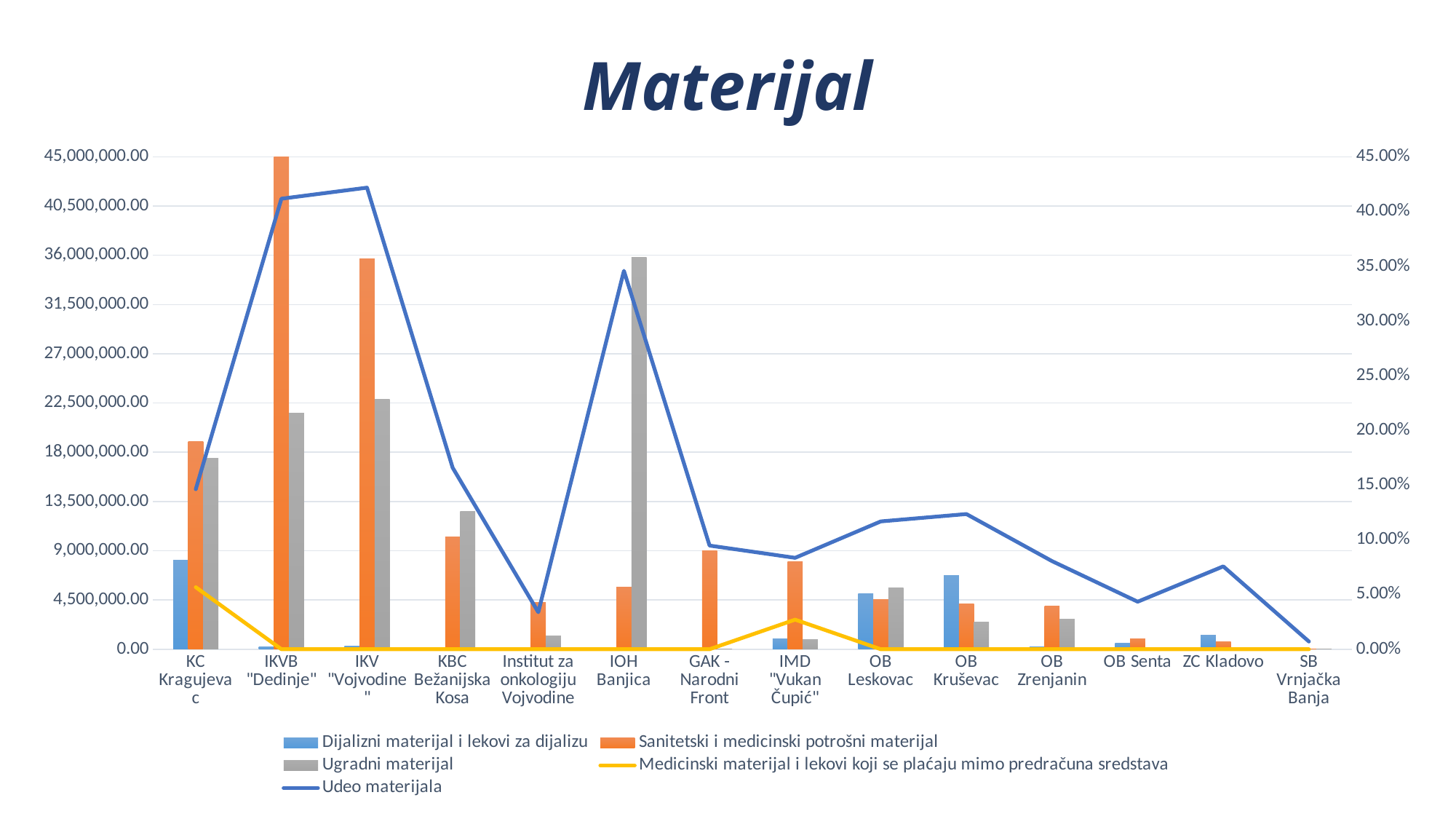
What kind of chart is this? Combination bar and line chart Is the value of Udeo materijala for Institut za onkologiju Vojvodine greater or less than 5.00%? less Is the value of Udeo materijala for IOH Banjica greater or less than 30.00%? greater Is the value of Sanitetski i medicinski potrošni materijal for IKVB "Dedinje" greater or less than 40,500,000.00? greater How many categories (institutions) are shown on the x axis? 14 How many series does the legend list? 5 Which category has the highest value for Ugradni materijal? IOH Banjica Which category has the lowest value for Udeo materijala? SB Vrnjačka Banja Which category has the highest value for Sanitetski i medicinski potrošni materijal? IKVB "Dedinje" Which category has the highest value for Dijalizni materijal i lekovi za dijalizu? KC Kragujevac What is the title of the chart? Materijal Which is larger: Ugradni materijal for IOH Banjica or for IKV "Vojvodine"? IOH Banjica